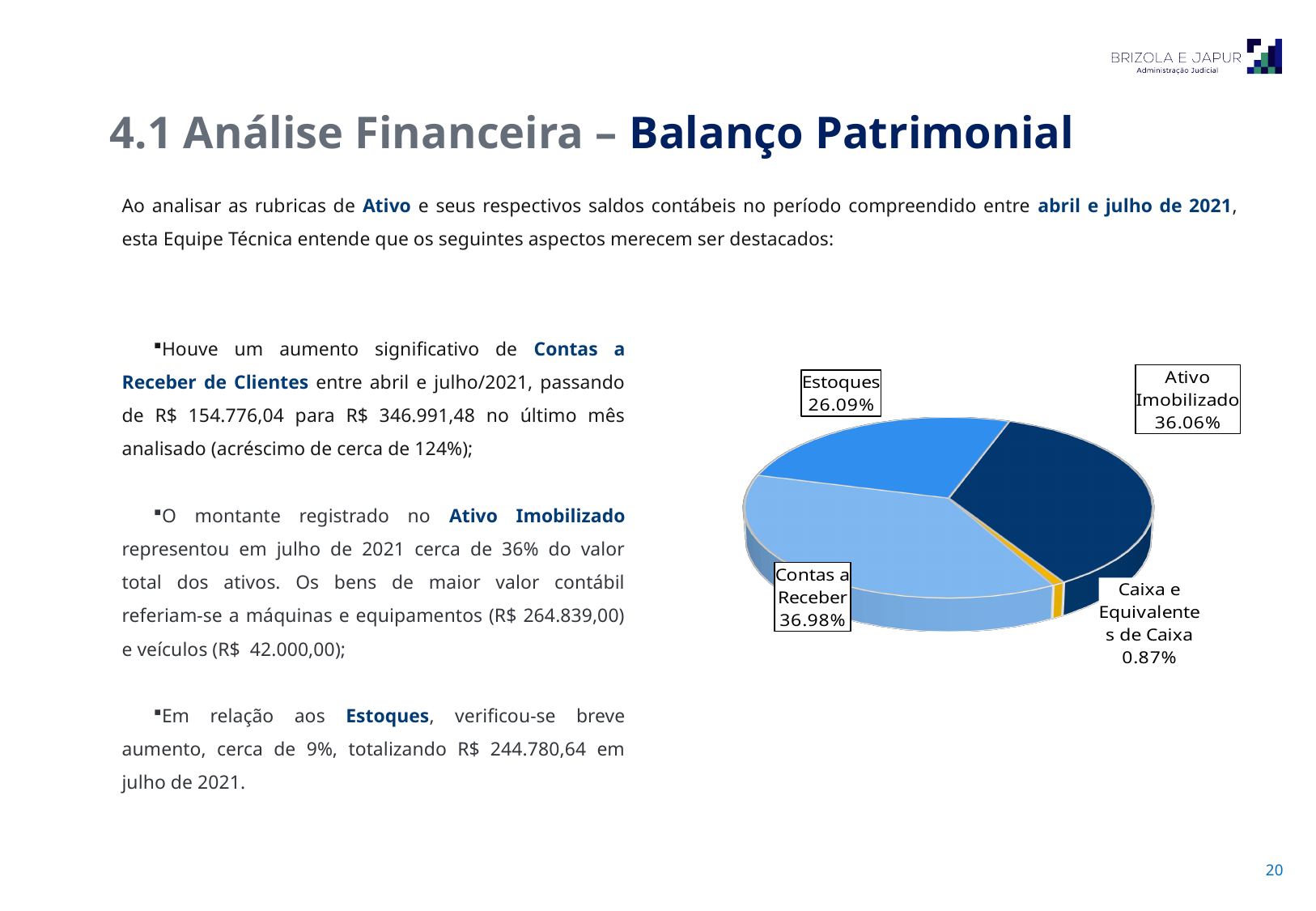
What is the percentage shown for Ativo Imobilizado? 36.06% What is the difference in percentage points between Contas a Receber and Ativo Imobilizado? 0.92% What is the percentage shown for Caixa e Equivalentes de Caixa? 0.87% Which category has the largest share of the pie? Contas a Receber Which slice of the pie chart is coloured yellow? Caixa e Equivalentes de Caixa What is the difference in percentage points between Ativo Imobilizado and Estoques? 9.97% What kind of chart is shown on the slide? pie chart Which is larger, the share for Ativo Imobilizado or the share for Estoques? Ativo Imobilizado What share of the pie does Estoques represent? 26.09% What is the percentage shown for Contas a Receber? 36.98% Which category has the smallest share of the pie? Caixa e Equivalentes de Caixa How many slices does the pie chart have? 4